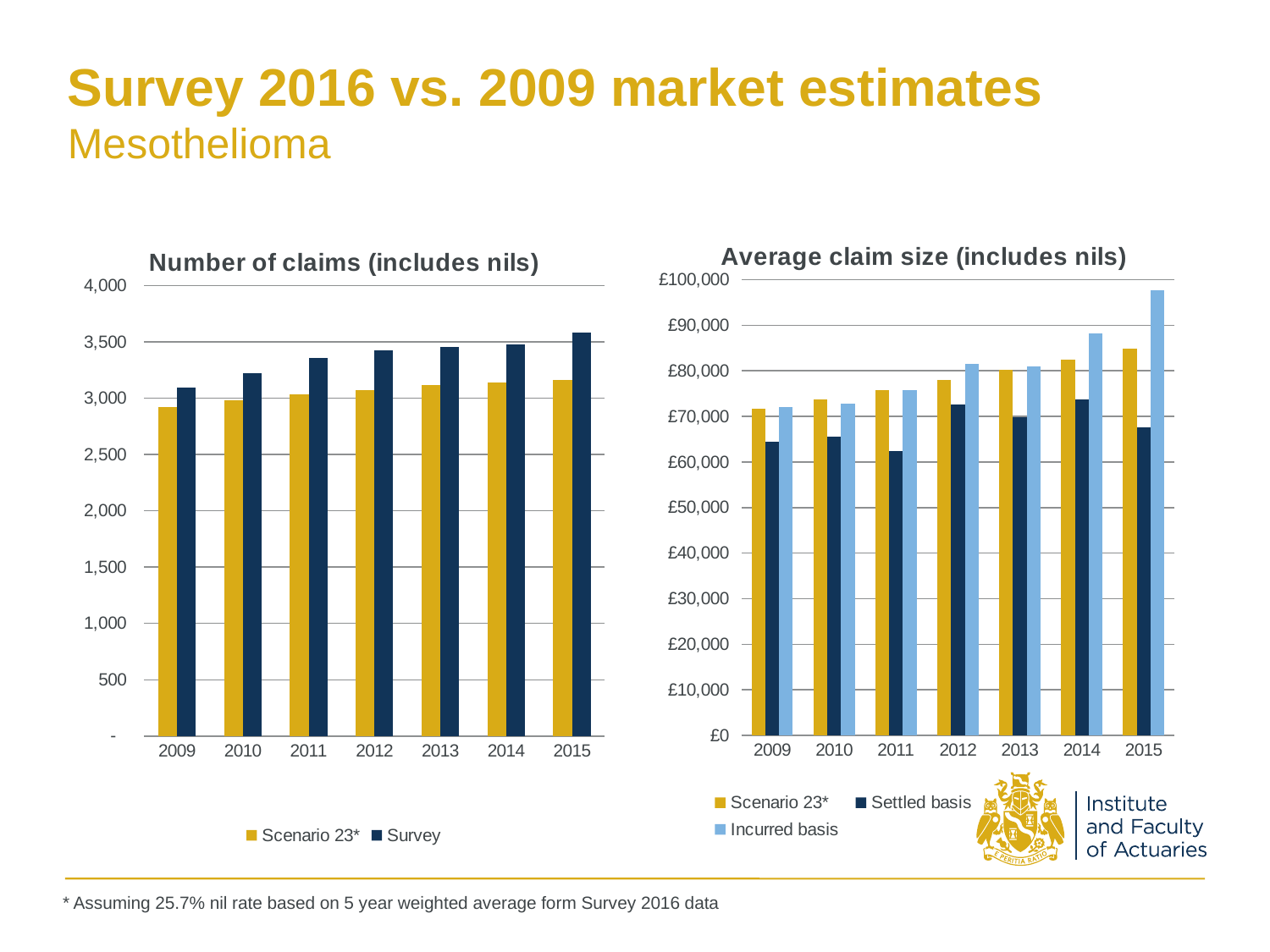
In the 'Number of claims (includes nils)' chart, how many series does the legend list? 2 In the 'Average claim size (includes nils)' chart, how many series does the legend list? 3 In the 'Average claim size (includes nils)' chart, is the Incurred basis value for 2015 greater or less than £90,000? greater In the 'Number of claims (includes nils)' chart, which is larger for 2009: Scenario 23* or Survey? Survey In the 'Average claim size (includes nils)' chart, is the Settled basis value for 2011 greater or less than £70,000? less In the 'Number of claims (includes nils)' chart, which year has the highest Survey value? 2015 In the 'Average claim size (includes nils)' chart, which year has the highest Incurred basis value? 2015 In the 'Number of claims (includes nils)' chart, is the Scenario 23* value for 2009 greater or less than 3,000? less In the 'Number of claims (includes nils)' chart, do the Survey values rise or fall from 2009 to 2015? rise In the 'Number of claims (includes nils)' chart, how many years are shown on the x axis? 7 What kind of chart is the 'Number of claims (includes nils)' chart? bar chart